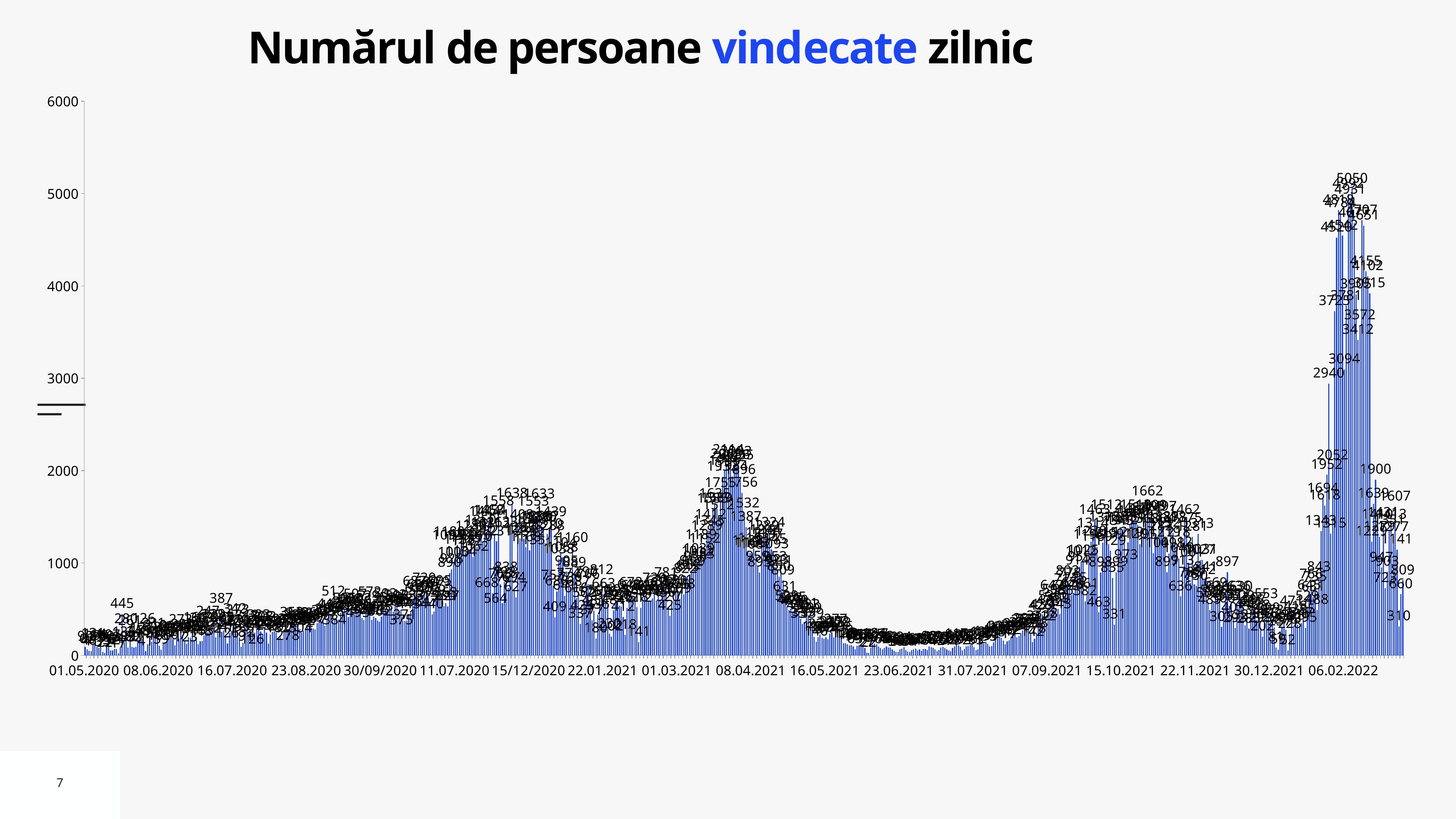
Are the values around 23.06.2021 greater or less than 500? less How many date labels are shown on the horizontal axis? 18 Is the peak value around 08.04.2021 greater or less than 2000? greater Which peak is higher: the one around 06.02.2022 or the one around 08.04.2021? the one around 06.02.2022 Do the values rise or fall between 08.04.2021 and 23.06.2021? fall What kind of chart is shown on the slide? bar chart What is the highest daily value labelled on the chart? 5050 Are the values around 01.05.2020 greater or less than 1000? less Do the values rise or fall between 23.06.2021 and 15.10.2021? rise What is the maximum value shown on the vertical axis? 6000 What is the title of the chart? Numărul de persoane vindecate zilnic